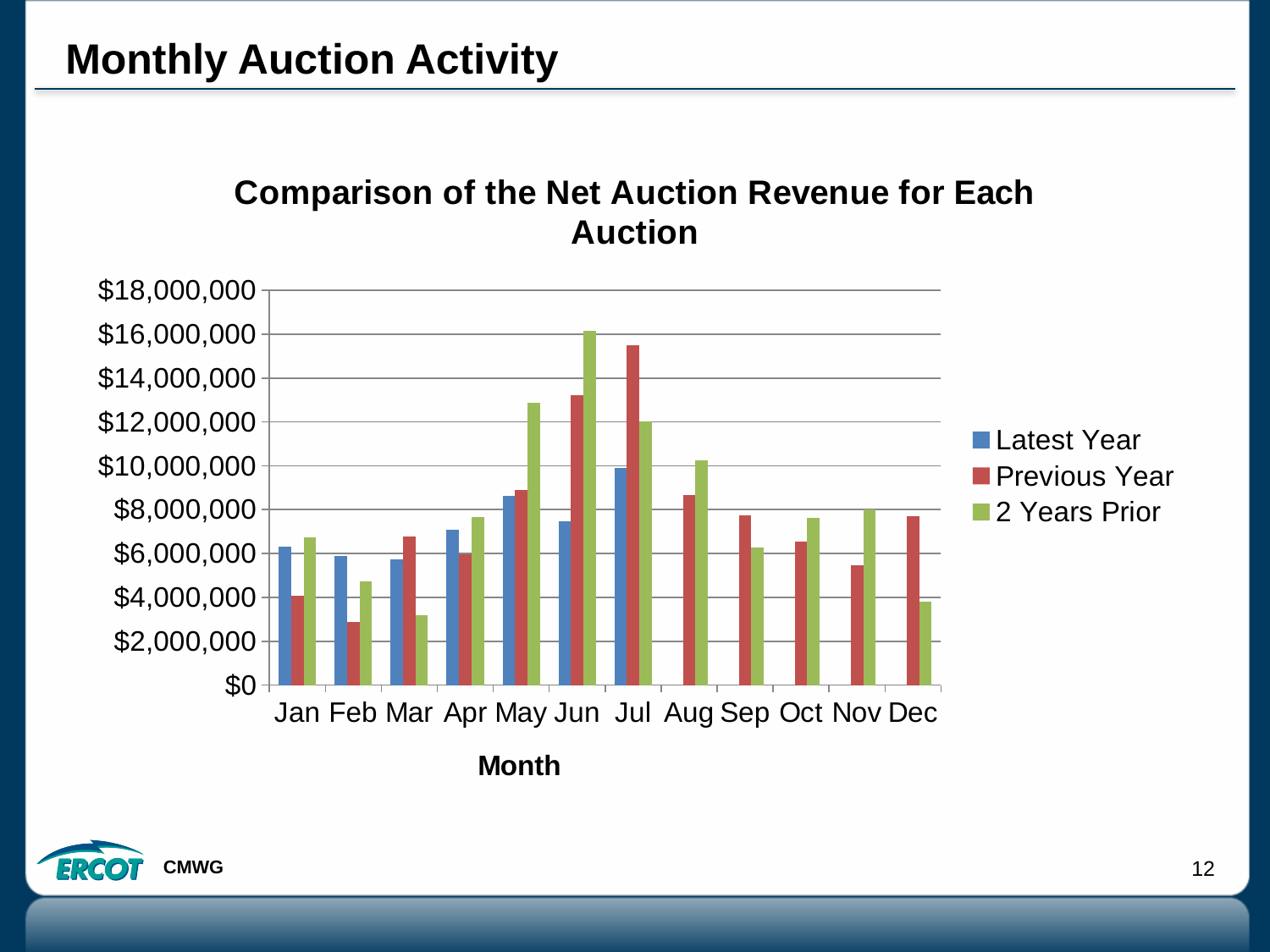
In which month is the Previous Year value highest? Jul In which month is the Latest Year value highest? Jul In Dec, which is larger: the Previous Year value or the 2 Years Prior value? Previous Year Is the Latest Year value for Jul greater or less than $8,000,000? greater In Jan, which is larger: the Latest Year value or the Previous Year value? Latest Year How many series does the legend list? 3 What is the title of the x axis? Month What kind of chart is shown on the slide? Bar chart In which month is the 2 Years Prior value highest? Jun Is the Previous Year value for Jun greater or less than $12,000,000? greater In which month is the Previous Year value lowest? Feb How many months are shown on the x axis? 12